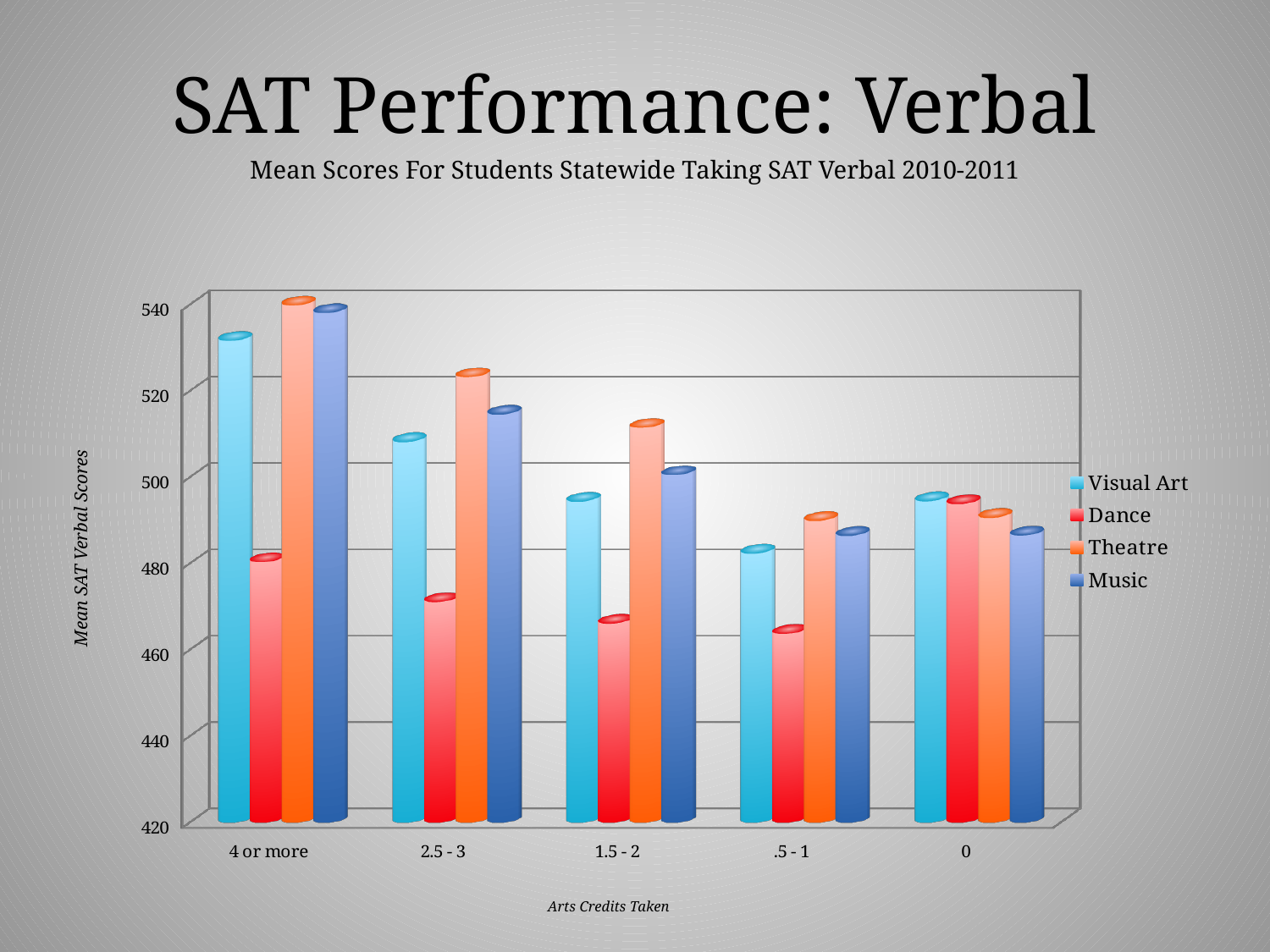
Does the Theatre series rise or fall from 4 or more to .5 - 1? fall How many series does the legend list? 4 What is the title of the x axis? Arts Credits Taken Is the Music value for .5 - 1 greater or less than 500? less Which series has the lowest value in the .5 - 1 category? Dance How many categories of Arts Credits Taken are shown on the x axis? 5 Which is larger, the Theatre value for 4 or more or the Dance value for 4 or more? Theatre What kind of chart is shown on the slide? bar chart Is the Theatre value for 2.5 - 3 greater or less than 500? greater Is the Dance value for 1.5 - 2 greater or less than 480? less Which series has the lowest value in the 2.5 - 3 category? Dance